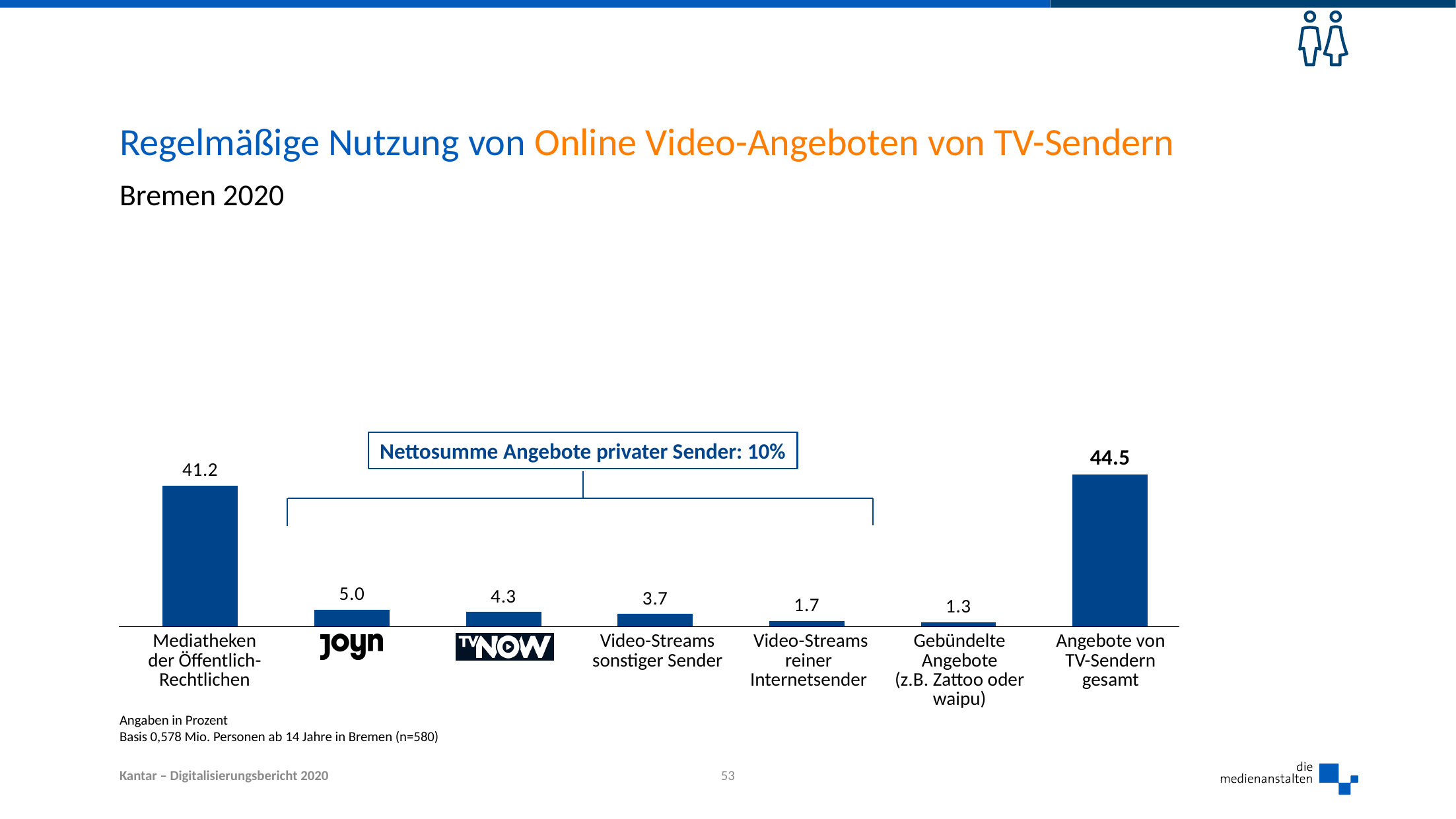
What is the difference between the values for Joyn and TV NOW? 0.7 How many categories are shown in the chart? 7 What is the value for Mediatheken der Öffentlich-Rechtlichen? 41.2 What is the value for Gebündelte Angebote (z.B. Zattoo oder waipu)? 1.3 Which category has the lowest value? Gebündelte Angebote (z.B. Zattoo oder waipu) What is the difference between the values for Angebote von TV-Sendern gesamt and Mediatheken der Öffentlich-Rechtlichen? 3.3 Which category has the highest value? Angebote von TV-Sendern gesamt What net sum is given in the box for the offerings of private broadcasters (Nettosumme Angebote privater Sender)? 10% What kind of chart is shown on the slide? Bar chart What is the value for Angebote von TV-Sendern gesamt? 44.5 What is the value for Video-Streams sonstiger Sender? 3.7 Which is larger, the value for Video-Streams sonstiger Sender or the value for Video-Streams reiner Internetsender? Video-Streams sonstiger Sender